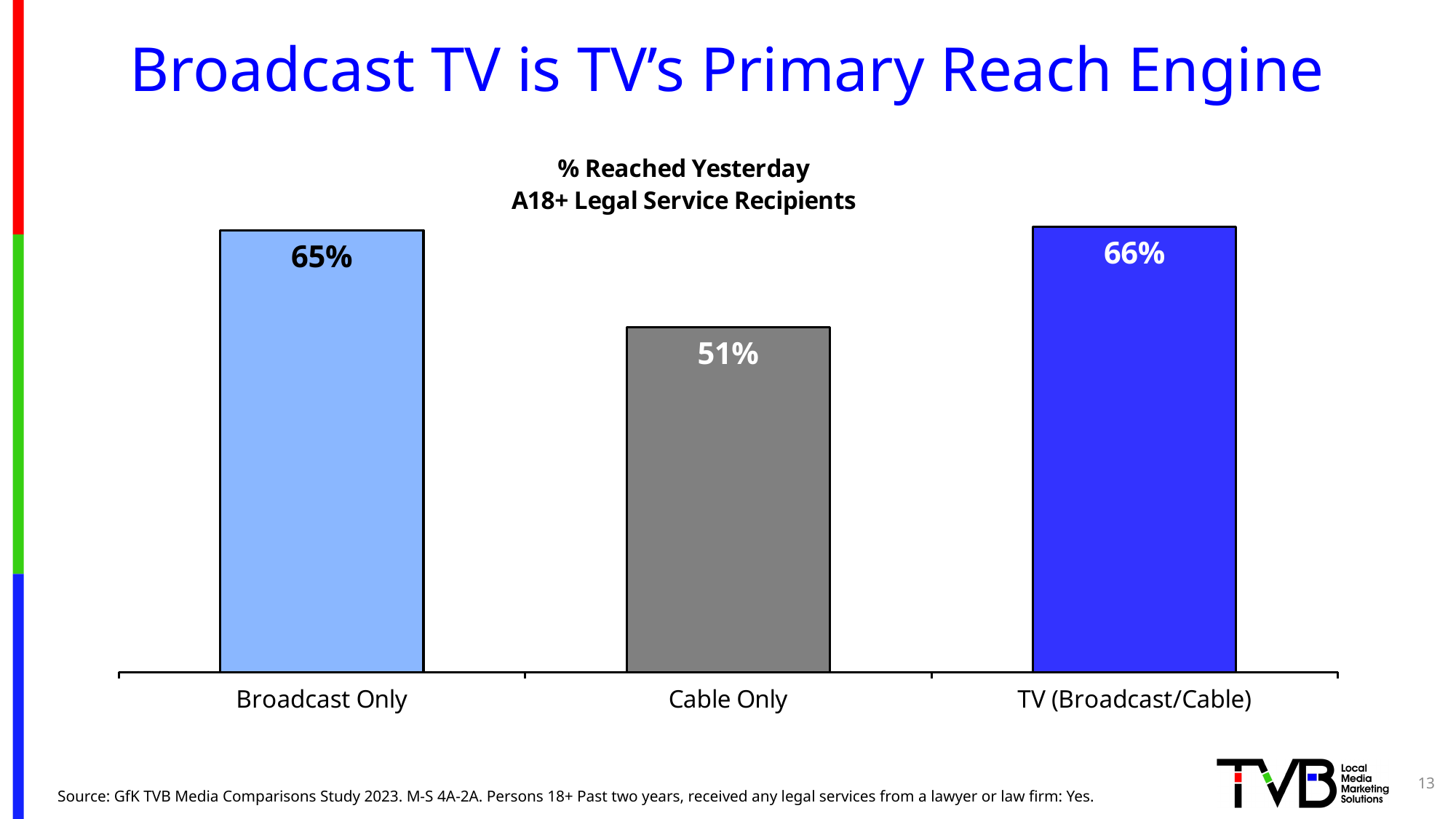
What is the difference between the values for TV (Broadcast/Cable) and Cable Only? 15% What kind of chart is shown on the slide? Bar chart What is the value for Broadcast Only? 65% What is the difference between the values for Broadcast Only and Cable Only? 14% Which category has the lowest value? Cable Only How many categories are shown in the chart? 3 What colour is the bar for Cable Only? Gray What is the title of the chart? % Reached Yesterday A18+ Legal Service Recipients Which is larger, the value for Broadcast Only or the value for Cable Only? Broadcast Only What is the value for TV (Broadcast/Cable)? 66% What is the value for Cable Only? 51%